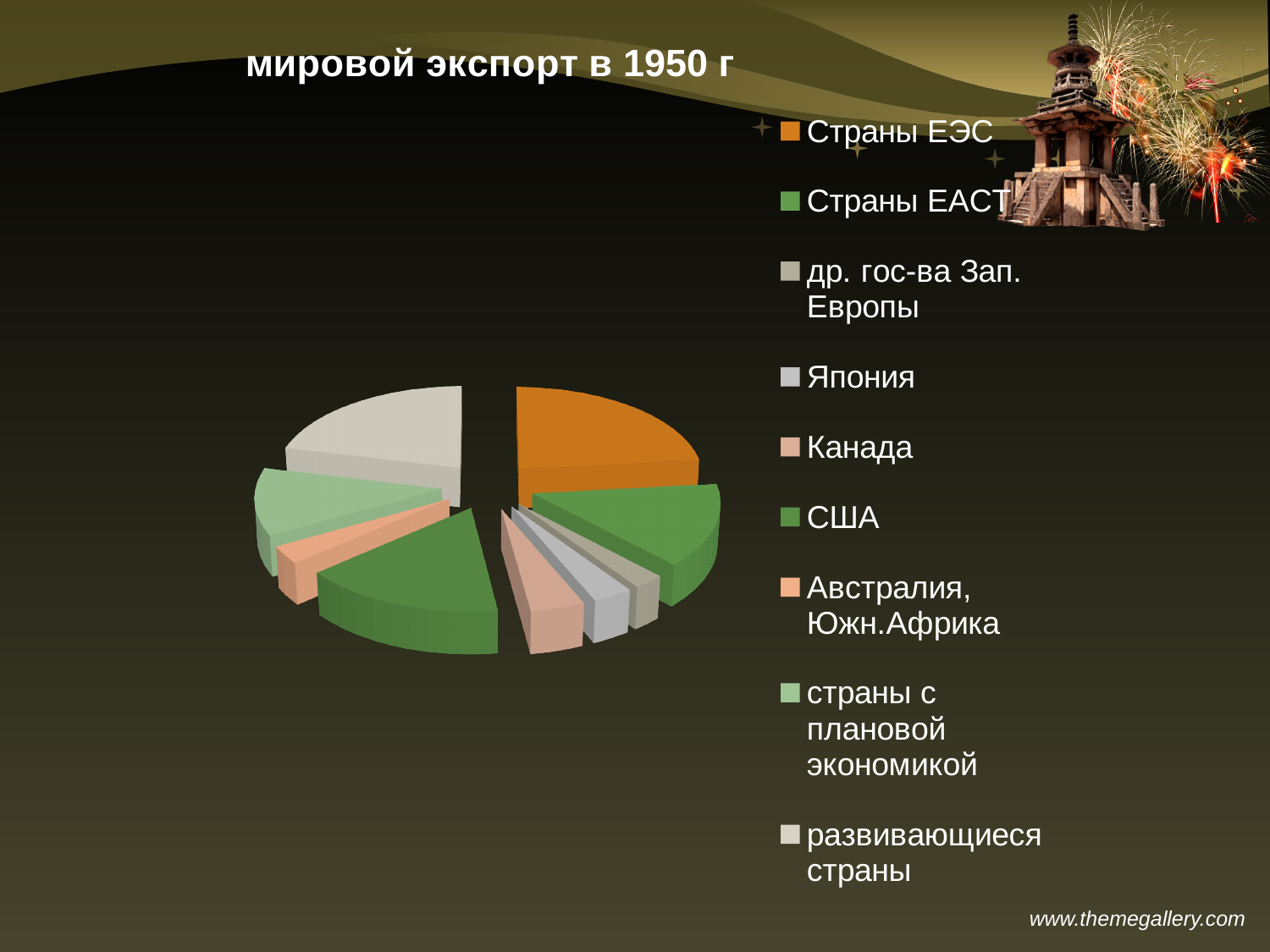
What colour is the slice for Страны ЕЭС? orange Which slice is larger: США or Япония? США Which slice is larger: страны с плановой экономикой or Канада? страны с плановой экономикой How many categories (slices) does the pie chart have? 9 What is the title of the chart? мировой экспорт в 1950 г Which slice is larger: Страны ЕЭС or Япония? Страны ЕЭС What kind of chart is shown on the slide? pie chart